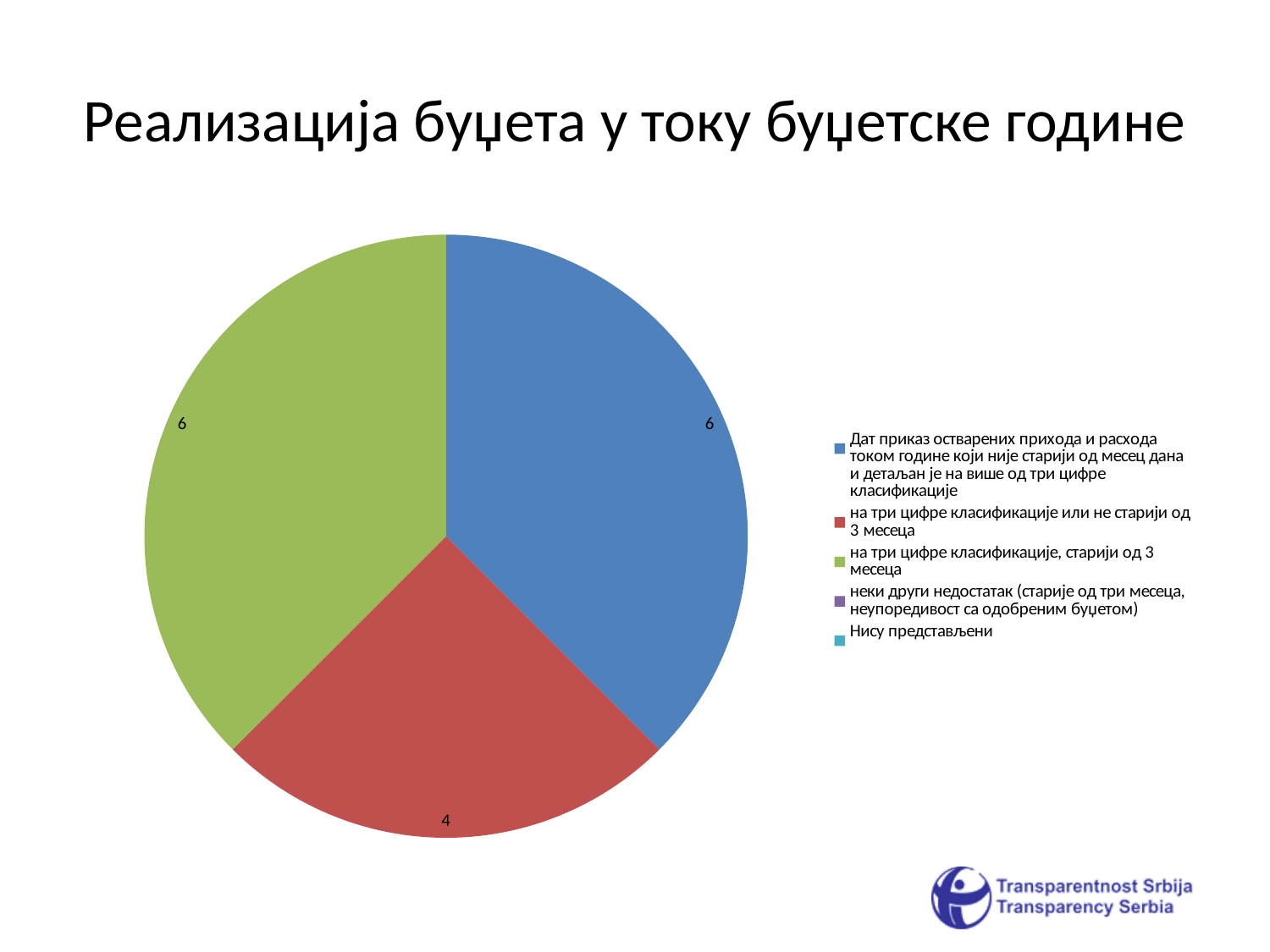
What is the value of the slice for "на три цифре класификације или не старији од 3 месеца"? 4 What colour is the slice for "на три цифре класификације или не старији од 3 месеца"? Red What is the title of the slide? Реализација буџета у току буџетске године Which is larger: the slice for "на три цифре класификације, старији од 3 месеца" or the slice for "на три цифре класификације или не старији од 3 месеца"? на три цифре класификације, старији од 3 месеца What is the difference between the value of the blue slice and the value of the red slice? 2 Which labelled slice has the smallest value? на три цифре класификације или не старији од 3 месеца What kind of chart is shown on the slide? Pie chart What is the value of the slice for "на три цифре класификације, старији од 3 месеца"? 6 How many entries does the legend list? 5 How many slices with data labels are visible in the pie chart? 3 What is the value of the slice for "Дат приказ остварених прихода и расхода током године који није старији од месец дана и детаљан је на више од три цифре класификације"? 6